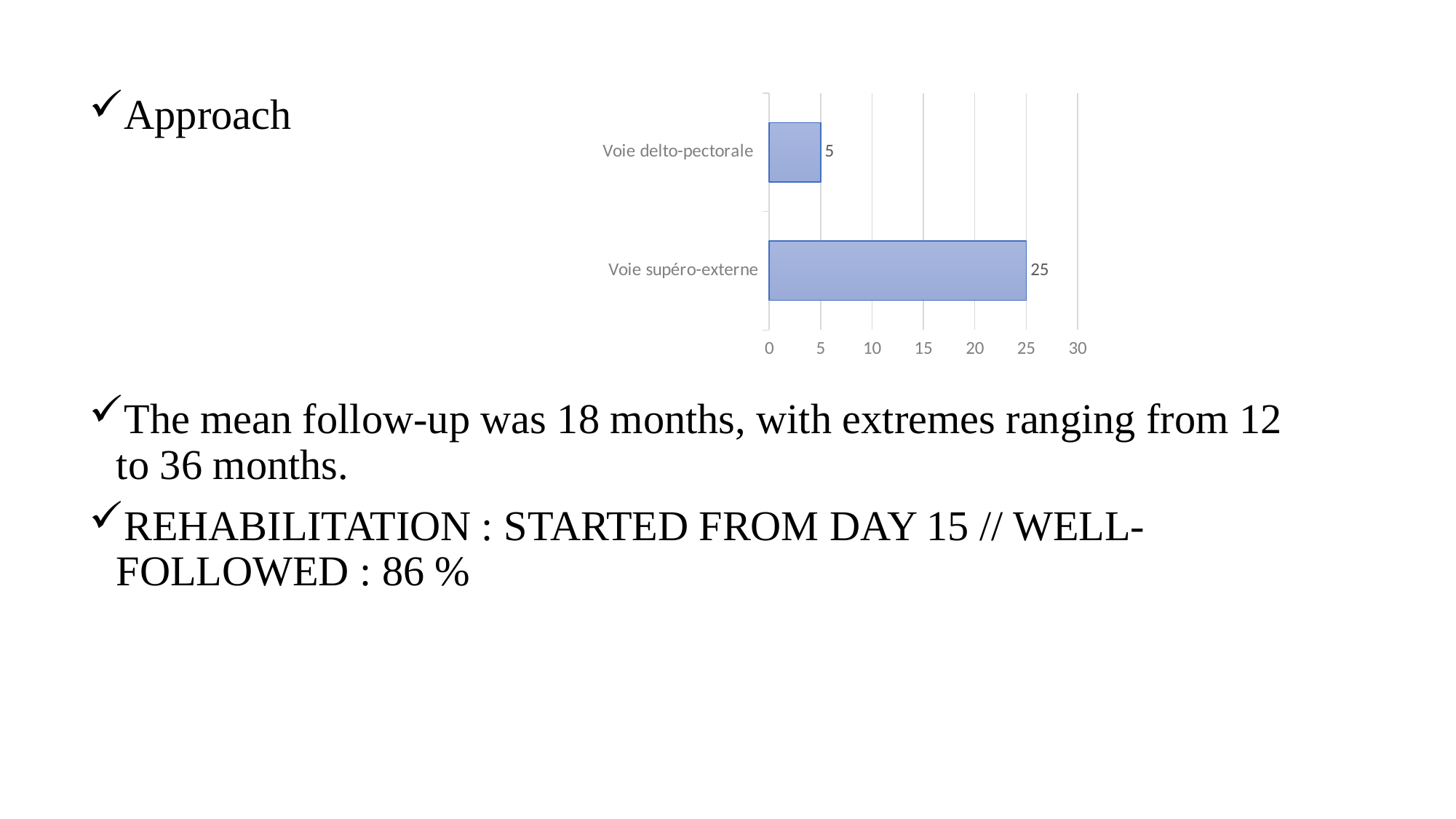
What is the value for Voie supéro-externe? 25 What is the maximum value shown on the x axis of the chart? 30 Is the value for Voie supéro-externe greater or less than 20? greater What kind of chart is shown on the slide? bar chart Which category has the highest value? Voie supéro-externe Which category has the lowest value? Voie delto-pectorale Is the value for Voie delto-pectorale greater or less than 10? less What is the total of the two values shown in the chart? 30 What is the difference between the values for Voie supéro-externe and Voie delto-pectorale? 20 Which is larger, the value for Voie delto-pectorale or the value for Voie supéro-externe? Voie supéro-externe What is the value for Voie delto-pectorale? 5 How many categories are shown in the chart? 2